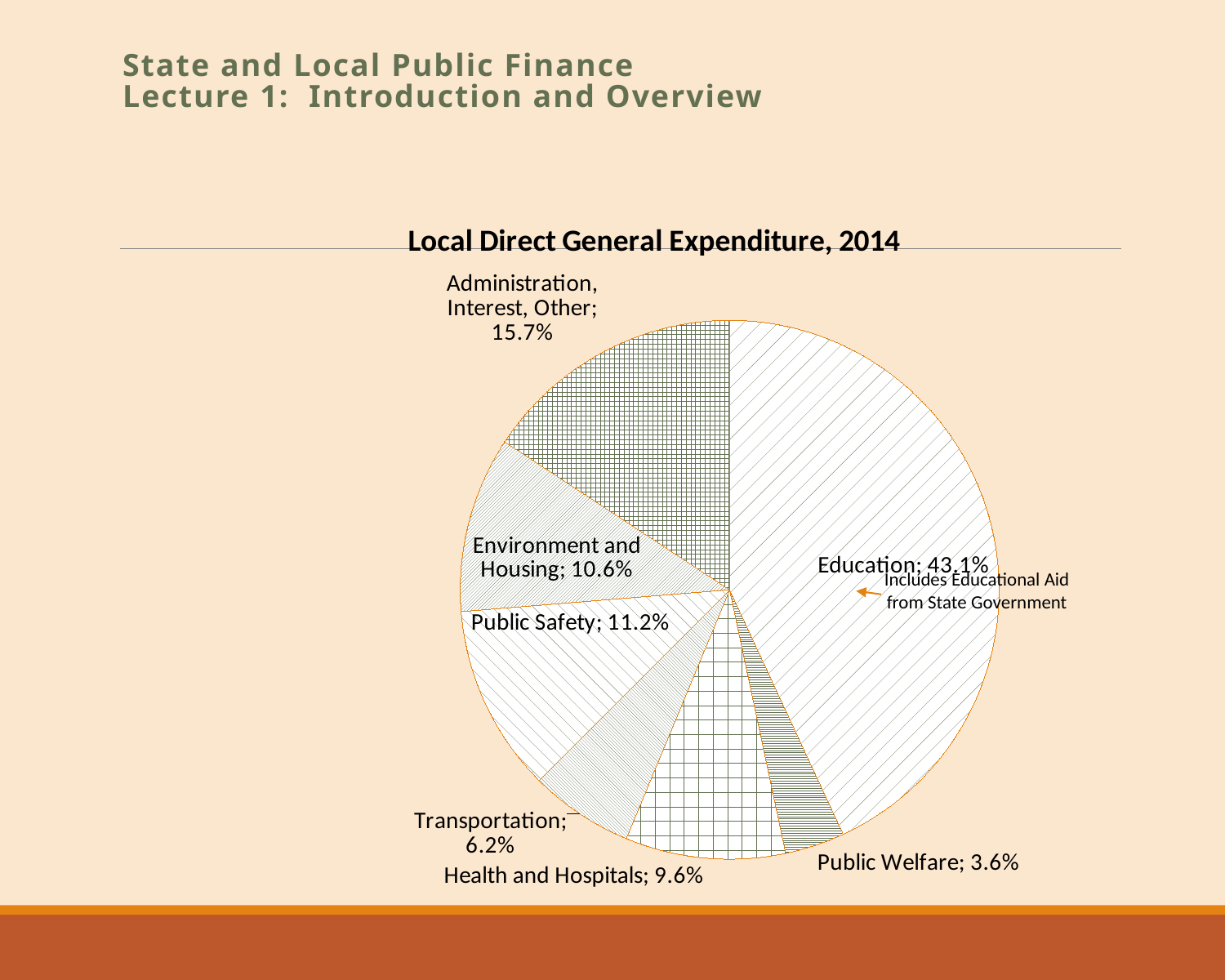
Which category has the largest slice of the pie? Education What share of Local Direct General Expenditure, 2014 goes to Education? 43.1% Which category has the smallest slice of the pie? Public Welfare What note is attached to the Education slice? Includes Educational Aid from State Government What is the title of the chart? Local Direct General Expenditure, 2014 Which is larger, the share for Transportation or the share for Health and Hospitals? Health and Hospitals How many categories are shown in the pie chart? 7 What is the value labelled for Health and Hospitals? 9.6% What share is shown for Administration, Interest, Other? 15.7% What percentage is shown for Public Welfare? 3.6% What kind of chart is shown on the slide? Pie chart What is the difference in percentage points between Public Safety and Environment and Housing? 0.6